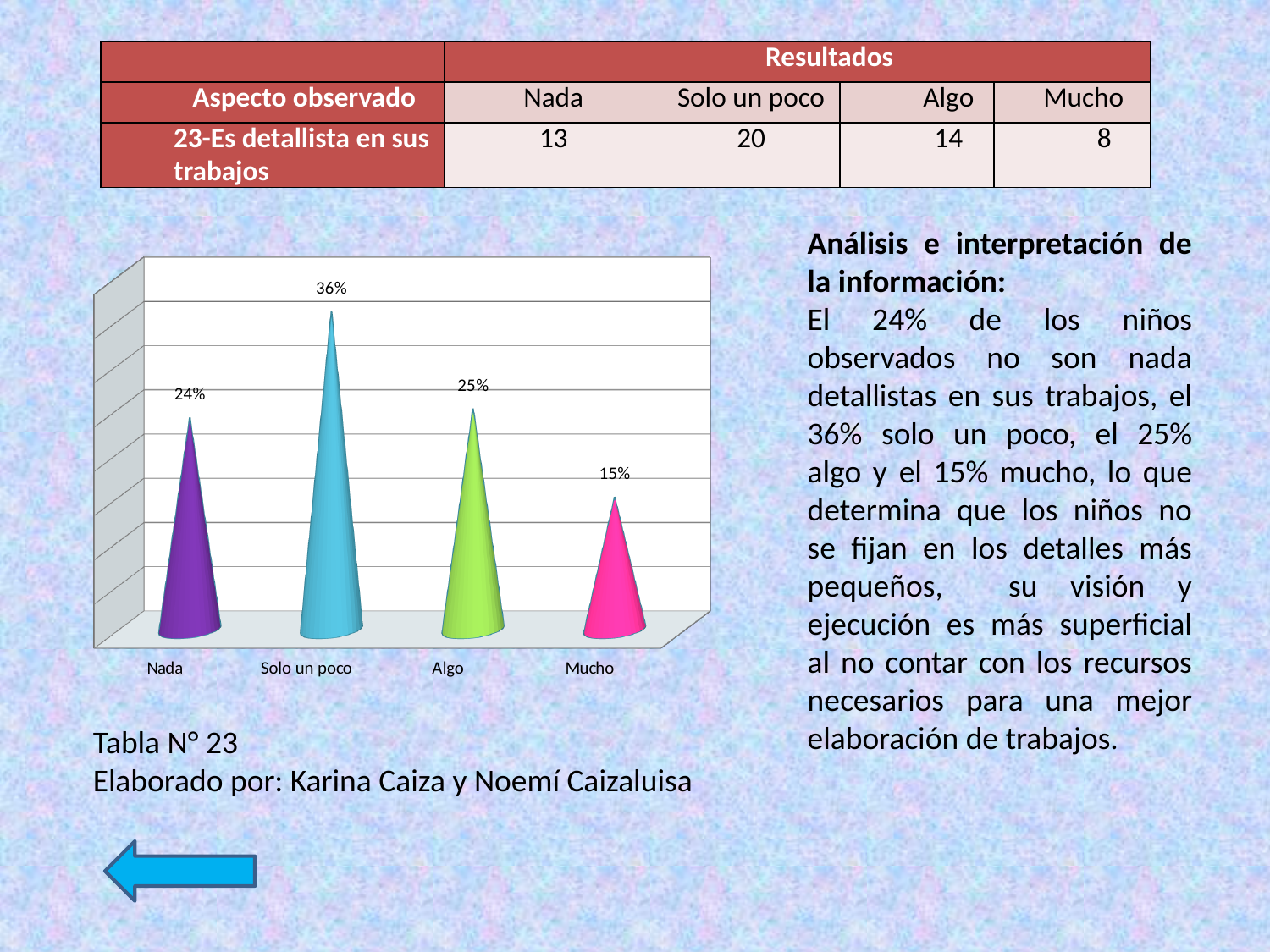
What kind of chart is shown? bar chart What colour is the bar for Solo un poco? blue What is the value shown for Nada? 24% What is the difference between the values for Solo un poco and Mucho? 21% What is the value shown for Algo? 25% Which is larger, the value for Nada or the value for Mucho? Nada How many categories are shown on the x axis? 4 What is the difference between the values for Algo and Nada? 1% What is the value shown for Solo un poco? 36% Which category has the lowest value? Mucho Which category has the highest value? Solo un poco What is the value shown for Mucho? 15%